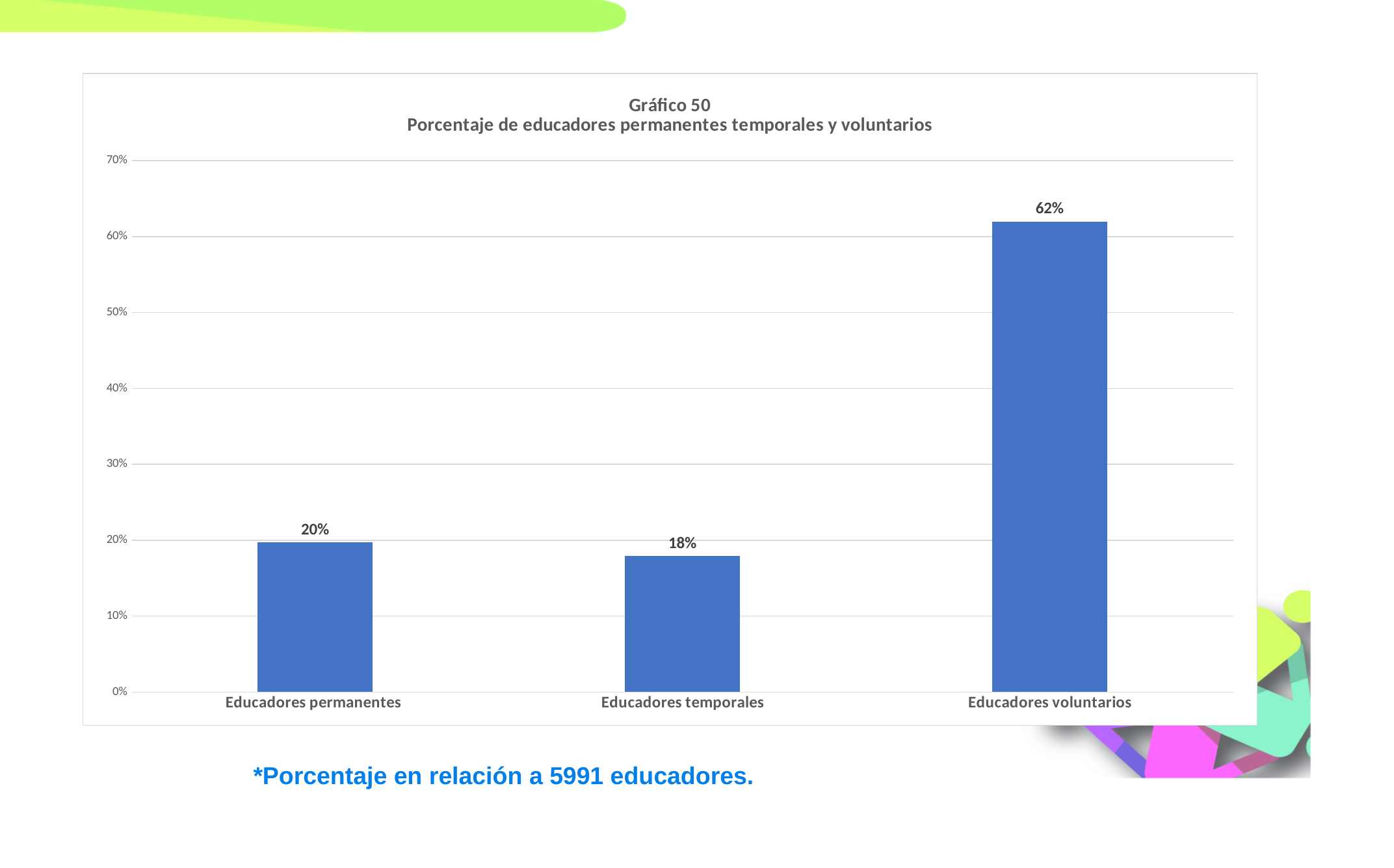
Is the value for Educadores voluntarios greater or less than 50%? greater What is the difference between the values for Educadores voluntarios and Educadores permanentes? 42% Which category has the highest value? Educadores voluntarios How many categories are shown in the chart? 3 What is the value for Educadores temporales? 18% What is the value for Educadores voluntarios? 62% What is the difference between the values for Educadores permanentes and Educadores temporales? 2% What is the title of the chart? Gráfico 50 Porcentaje de educadores permanentes temporales y voluntarios Which is larger, the value for Educadores voluntarios or the value for Educadores temporales? Educadores voluntarios What kind of chart is shown on the slide? bar chart What is the value for Educadores permanentes? 20% Which category has the lowest value? Educadores temporales